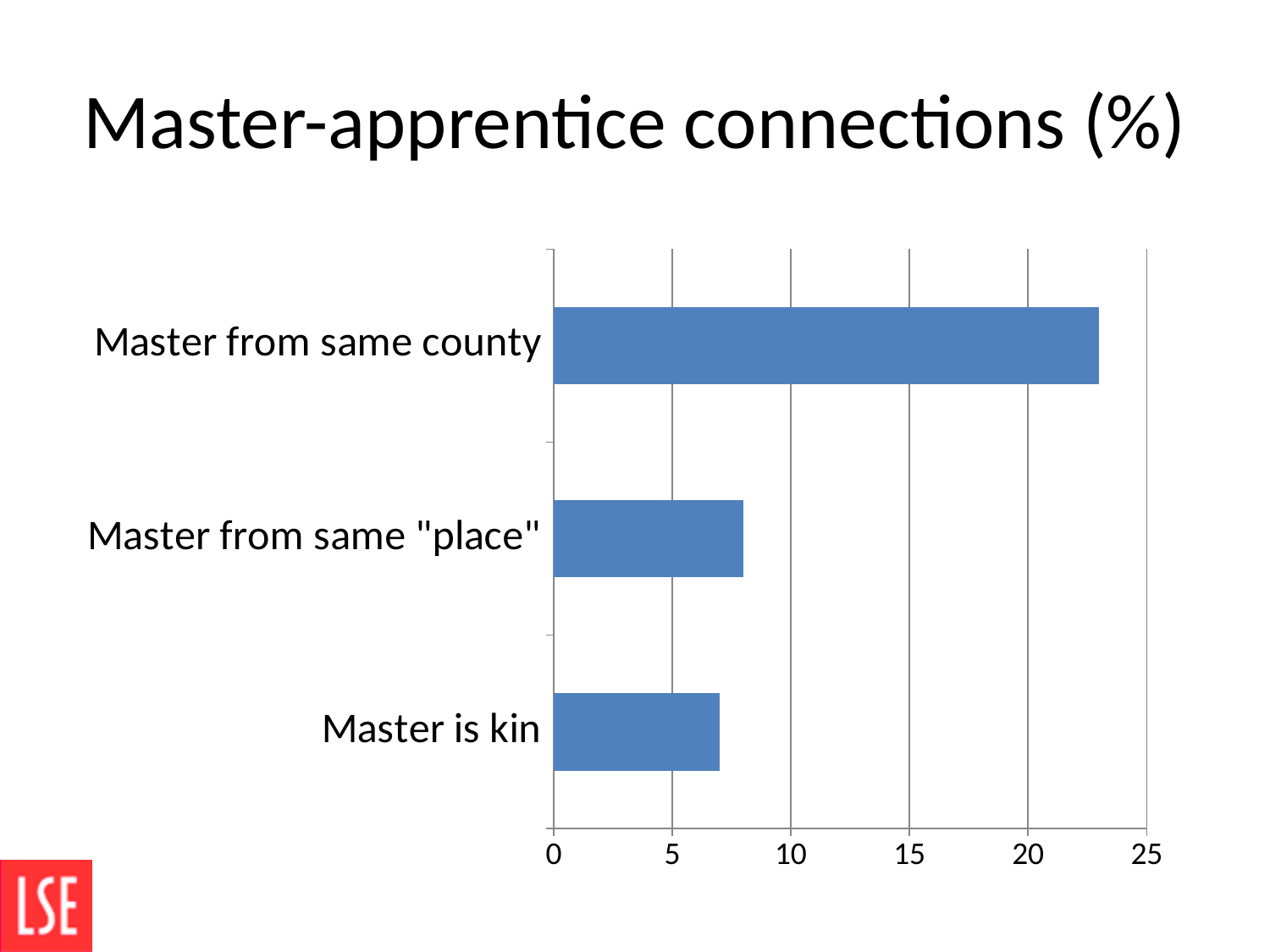
Is the value for Master from same county greater or less than 20? greater Is the value for Master is kin greater or less than 10? less What is the title of the chart? Master-apprentice connections (%) What kind of chart is shown on the slide? bar chart Is the value for Master from same county greater or less than 25? less How many categories are plotted in the chart? 3 Which is larger, the value for Master from same county or the value for Master is kin? Master from same county Which category has the highest value? Master from same county What is the maximum value shown on the horizontal axis? 25